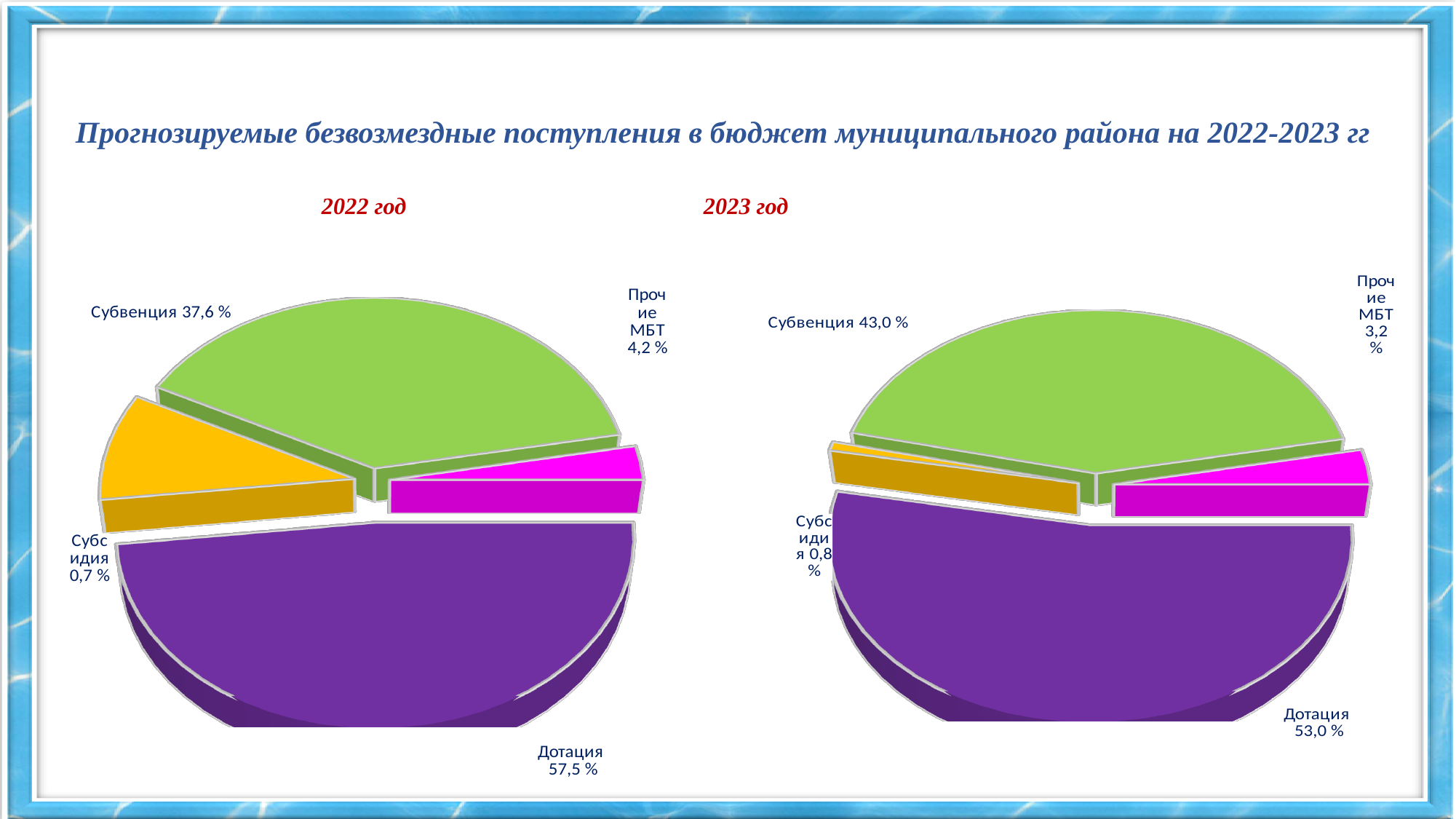
What type of chart is used for 2023 год? Pie chart What colour is the Дотация slice on the 2022 год pie chart? Purple How many slices does the 2022 год pie chart have? 4 On the 2023 год pie chart, what share is labelled for Субвенция? 43,0 % What is the difference between the Прочие МБТ share in 2022 год and in 2023 год? 1,0 % On the 2023 год pie chart, which category has the largest share? Дотация On the 2022 год pie chart, what share is labelled for Прочие МБТ? 4,2 % What is the difference between the Дотация share in 2022 год and in 2023 год? 4,5 % On the 2022 год pie chart, which category has the smallest labelled share? Субсидия On the 2022 год pie chart, what share is labelled for Дотация? 57,5 % Which is larger: the Субвенция share in 2022 год or in 2023 год? 2023 год On the 2023 год pie chart, what share is labelled for Субсидия? 0,8 %